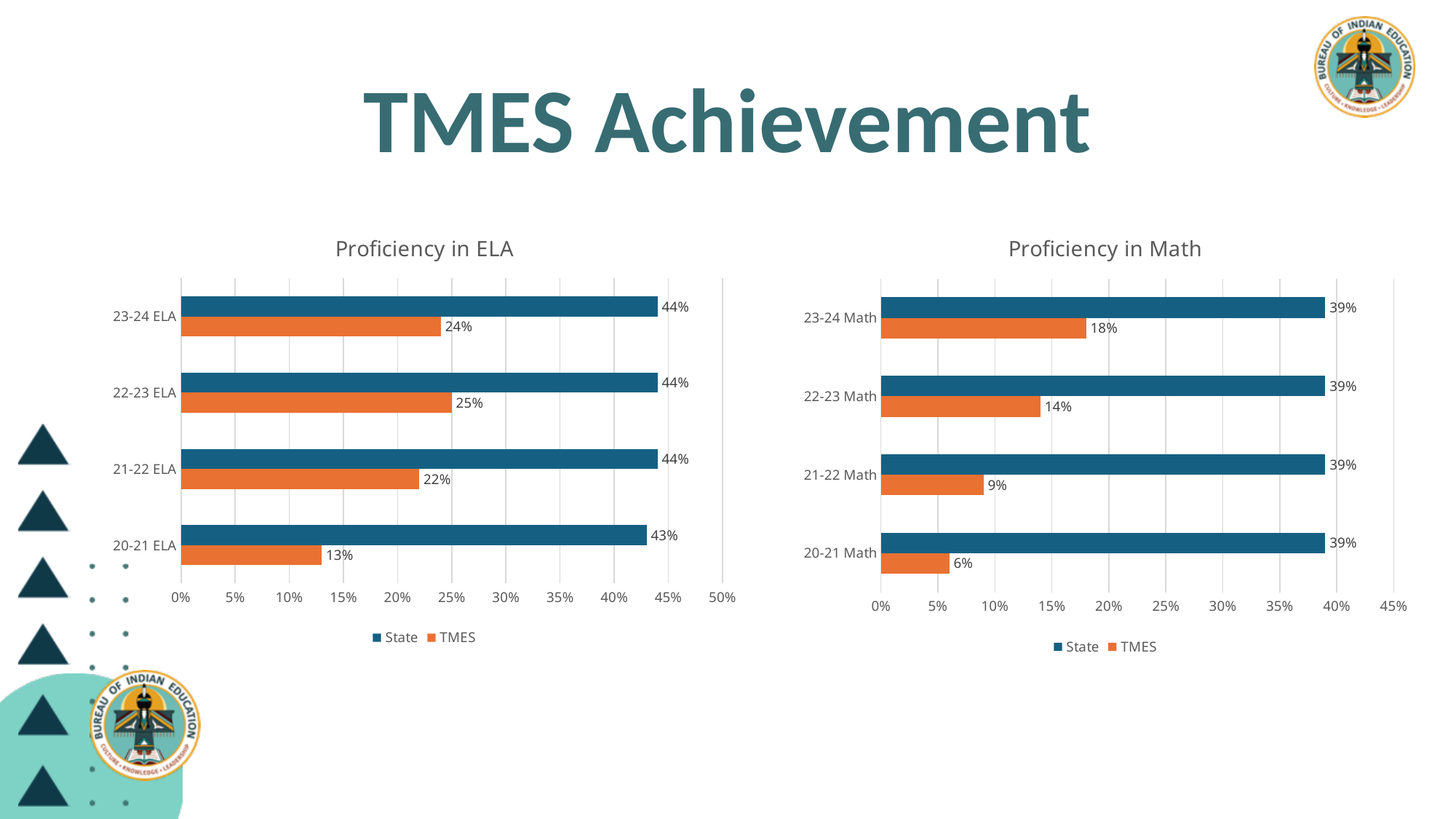
What kind of chart is the Proficiency in Math chart? Bar chart In the Proficiency in ELA chart, which category has the lowest TMES value? 20-21 ELA How many categories are shown in the Proficiency in Math chart? 4 In the Proficiency in Math chart, what is the TMES value for 20-21 Math? 6% In the Proficiency in ELA chart, what is the TMES value for 23-24 ELA? 24% In the Proficiency in ELA chart, what is the difference between the State and TMES values for 22-23 ELA? 19% In the Proficiency in Math chart, which category has the highest TMES value? 23-24 Math In the Proficiency in ELA chart, what is the State value for 20-21 ELA? 43% In the Proficiency in ELA chart, which is larger, the TMES value for 22-23 ELA or the TMES value for 21-22 ELA? 22-23 ELA In the Proficiency in Math chart, what colour are the TMES bars? Orange In the Proficiency in Math chart, what is the difference between the TMES values for 23-24 Math and 22-23 Math? 4% How many series does the legend of the Proficiency in ELA chart list? 2